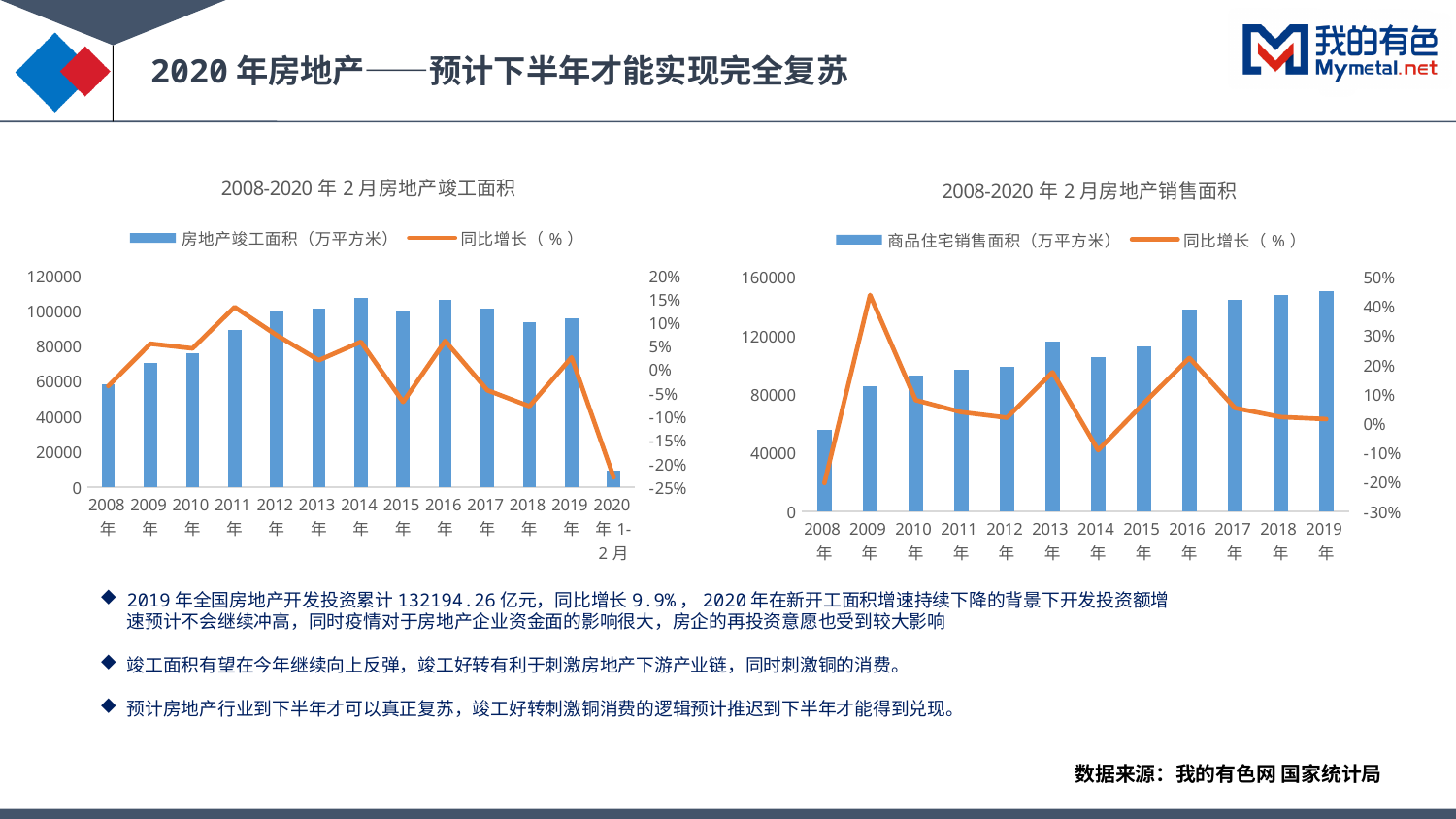
In the right chart (2008-2020年2月房地产销售面积), which year has the highest 同比增长 value on the line? 2009年 In the left chart (2008-2020年2月房地产竣工面积), which category has the lowest 房地产竣工面积 bar? 2020年1-2月 How many categories are shown on the x axis of the right chart (2008-2020年2月房地产销售面积)? 12 In the right chart (2008-2020年2月房地产销售面积), is the 商品住宅销售面积 bar for 2016年 greater or less than 120000? greater What type of chart is the left chart titled 2008-2020年2月房地产竣工面积? Combined bar and line chart In the left chart (2008-2020年2月房地产竣工面积), is the 房地产竣工面积 bar for 2011年 greater or less than 80000? greater In the right chart (2008-2020年2月房地产销售面积), do the 商品住宅销售面积 bars generally rise or fall from 2008年 to 2019年? rise What is the legend label of the bar series in the left chart (2008-2020年2月房地产竣工面积)? 房地产竣工面积（万平方米） How many series does the legend of the right chart (2008-2020年2月房地产销售面积) list? 2 In the right chart (2008-2020年2月房地产销售面积), which year has the lowest 商品住宅销售面积 bar? 2008年 In the right chart (2008-2020年2月房地产销售面积), which year has the highest 商品住宅销售面积 bar? 2019年 How many categories are shown on the x axis of the left chart (2008-2020年2月房地产竣工面积)? 13